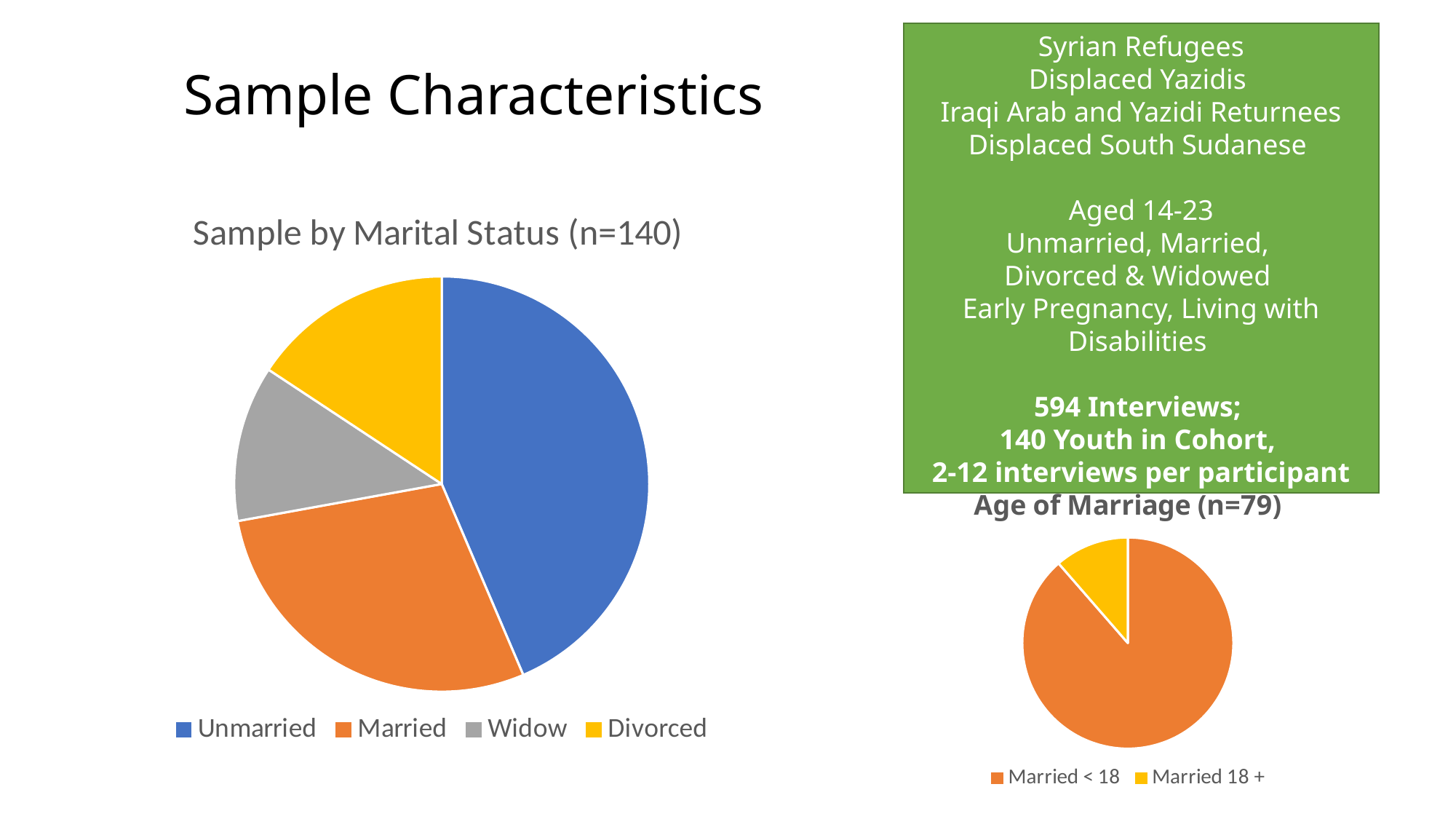
In the "Age of Marriage (n=79)" chart, which category has the largest slice? Married < 18 What are the legend entries of the "Age of Marriage (n=79)" chart? Married < 18, Married 18 + In the "Sample by Marital Status (n=140)" chart, which slice is larger, Married or Widow? Married In the "Age of Marriage (n=79)" chart, which slice is larger, Married < 18 or Married 18 +? Married < 18 How many categories does the "Sample by Marital Status (n=140)" pie chart show? 4 How many categories does the "Age of Marriage (n=79)" pie chart show? 2 What kind of chart is the "Age of Marriage (n=79)" chart? pie chart In the "Age of Marriage (n=79)" chart, which category has the smallest slice? Married 18 + What kind of chart is the "Sample by Marital Status (n=140)" chart? pie chart What is the title of the pie chart on the left of the slide? Sample by Marital Status (n=140) In the "Sample by Marital Status (n=140)" chart, which slice is larger, Unmarried or Married? Unmarried In the "Sample by Marital Status (n=140)" chart, which marital status has the largest slice? Unmarried